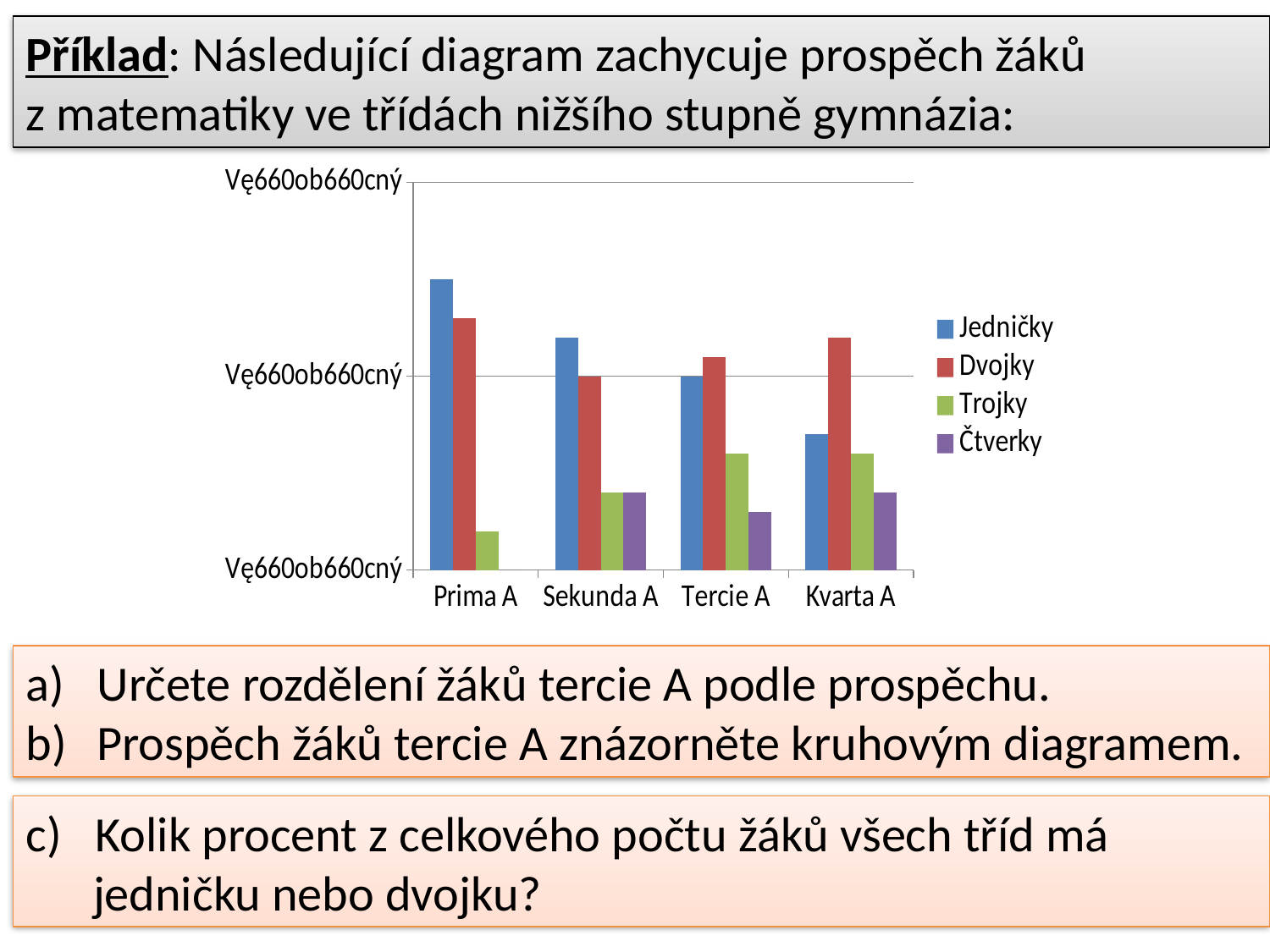
In Tercie A, which is larger, Jedničky or Dvojky? Dvojky Which series has the tallest bar for Prima A? Jedničky In Kvarta A, which is larger, Jedničky or Dvojky? Dvojky Which class has the lowest value for Čtverky? Prima A How many classes are shown on the x axis of the chart? 4 What kind of chart is shown on the slide? bar chart How many series does the legend list? 4 Which series has the shortest bar for Tercie A? Čtverky Which class has the highest value for Jedničky? Prima A Which class has the lowest value for Trojky? Prima A What colour are the Dvojky bars in the chart? red Which is larger, Jedničky for Prima A or Jedničky for Sekunda A? Prima A